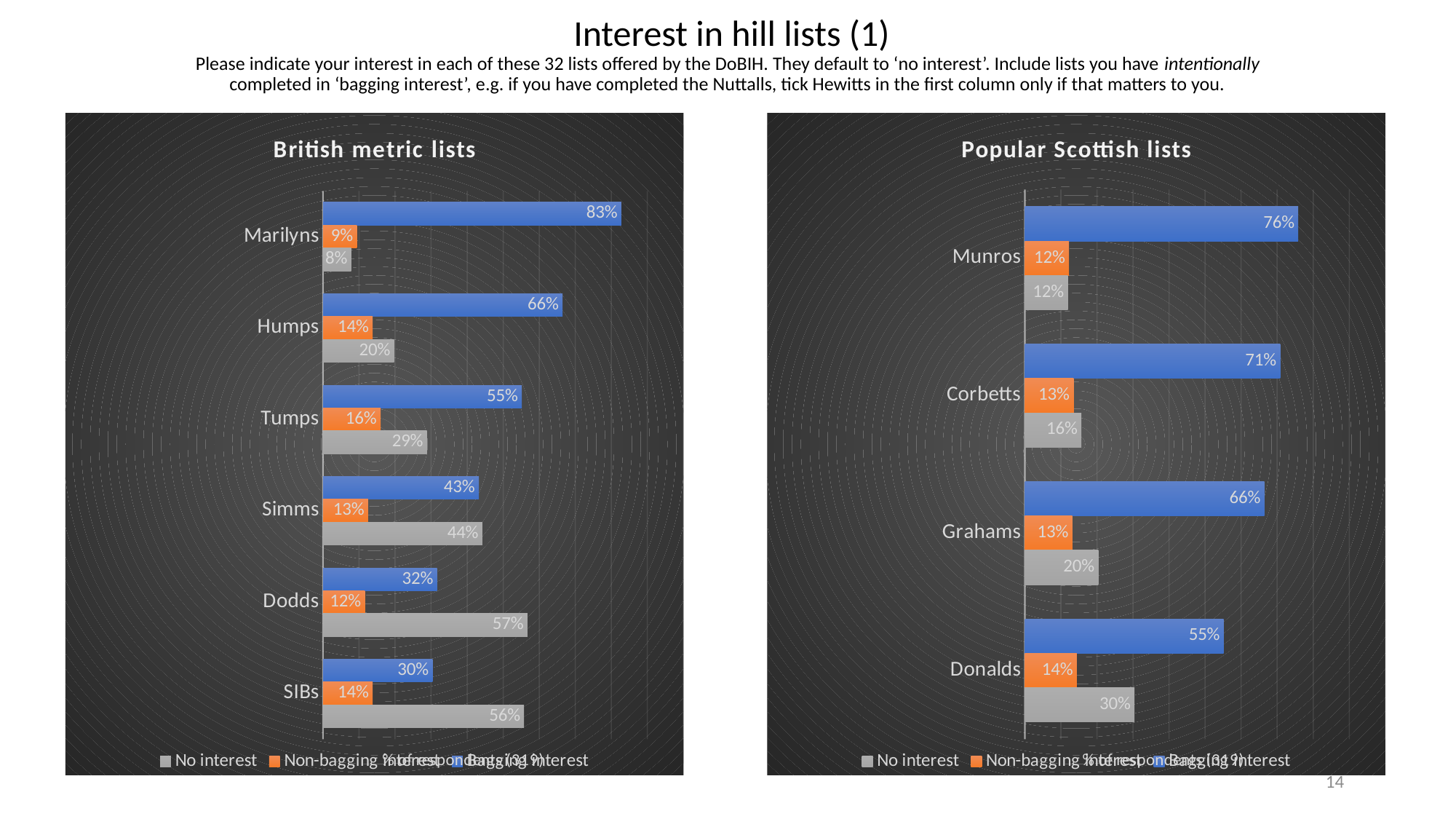
In the British metric lists chart, what is the bagging interest value for Marilyns? 83% In the Popular Scottish lists chart, what is the non-bagging interest value for Grahams? 13% How many lists are shown in the Popular Scottish lists chart? 4 In the Popular Scottish lists chart, which list has the lowest bagging interest value? Donalds What kind of chart is the British metric lists chart? Bar chart How many series does the legend of the Popular Scottish lists chart list? 3 In the British metric lists chart, what is the difference between the bagging interest values for Marilyns and SIBs? 53% In the Popular Scottish lists chart, which is larger: the bagging interest for Munros or for Corbetts? Munros In the British metric lists chart, which list has the highest no interest value? Dodds How many lists are shown in the British metric lists chart? 6 In the British metric lists chart, what is the difference between the no interest and bagging interest values for Simms? 1% In the Popular Scottish lists chart, what is the no interest value for Donalds? 30%